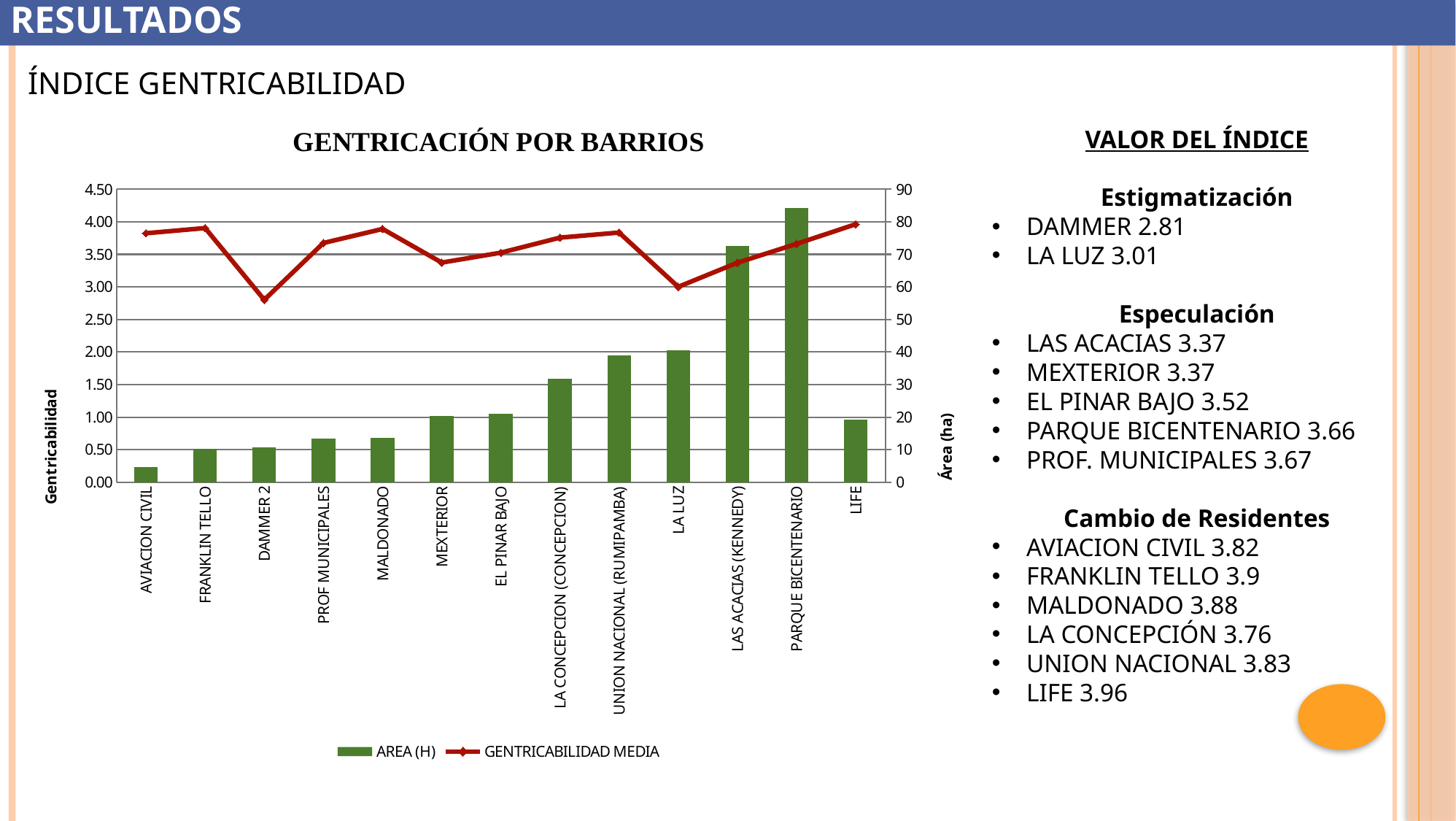
In the GENTRICACIÓN POR BARRIOS chart, is the AREA (H) value for PARQUE BICENTENARIO greater or less than 80? greater In the GENTRICACIÓN POR BARRIOS chart, is the GENTRICABILIDAD MEDIA value for DAMMER 2 greater or less than 3.00? less In the GENTRICACIÓN POR BARRIOS chart, which has the larger AREA (H) bar: LAS ACACIAS (KENNEDY) or PARQUE BICENTENARIO? PARQUE BICENTENARIO Which neighbourhood has the highest AREA (H) bar in the GENTRICACIÓN POR BARRIOS chart? PARQUE BICENTENARIO How many neighbourhoods (categories) are shown on the x axis of the GENTRICACIÓN POR BARRIOS chart? 13 What kind of chart is GENTRICACIÓN POR BARRIOS? A bar chart combined with a line chart In the GENTRICACIÓN POR BARRIOS chart, do the AREA (H) bars generally rise or fall from AVIACION CIVIL to PARQUE BICENTENARIO? rise What is the title of the right-hand vertical axis in the GENTRICACIÓN POR BARRIOS chart? Área (ha) How many series does the legend of the GENTRICACIÓN POR BARRIOS chart list? 2 Which neighbourhood has the lowest GENTRICABILIDAD MEDIA value on the line in the GENTRICACIÓN POR BARRIOS chart? DAMMER 2 In the GENTRICACIÓN POR BARRIOS chart, is the AREA (H) value for AVIACION CIVIL greater or less than 10? less Which neighbourhood has the lowest AREA (H) bar in the GENTRICACIÓN POR BARRIOS chart? AVIACION CIVIL